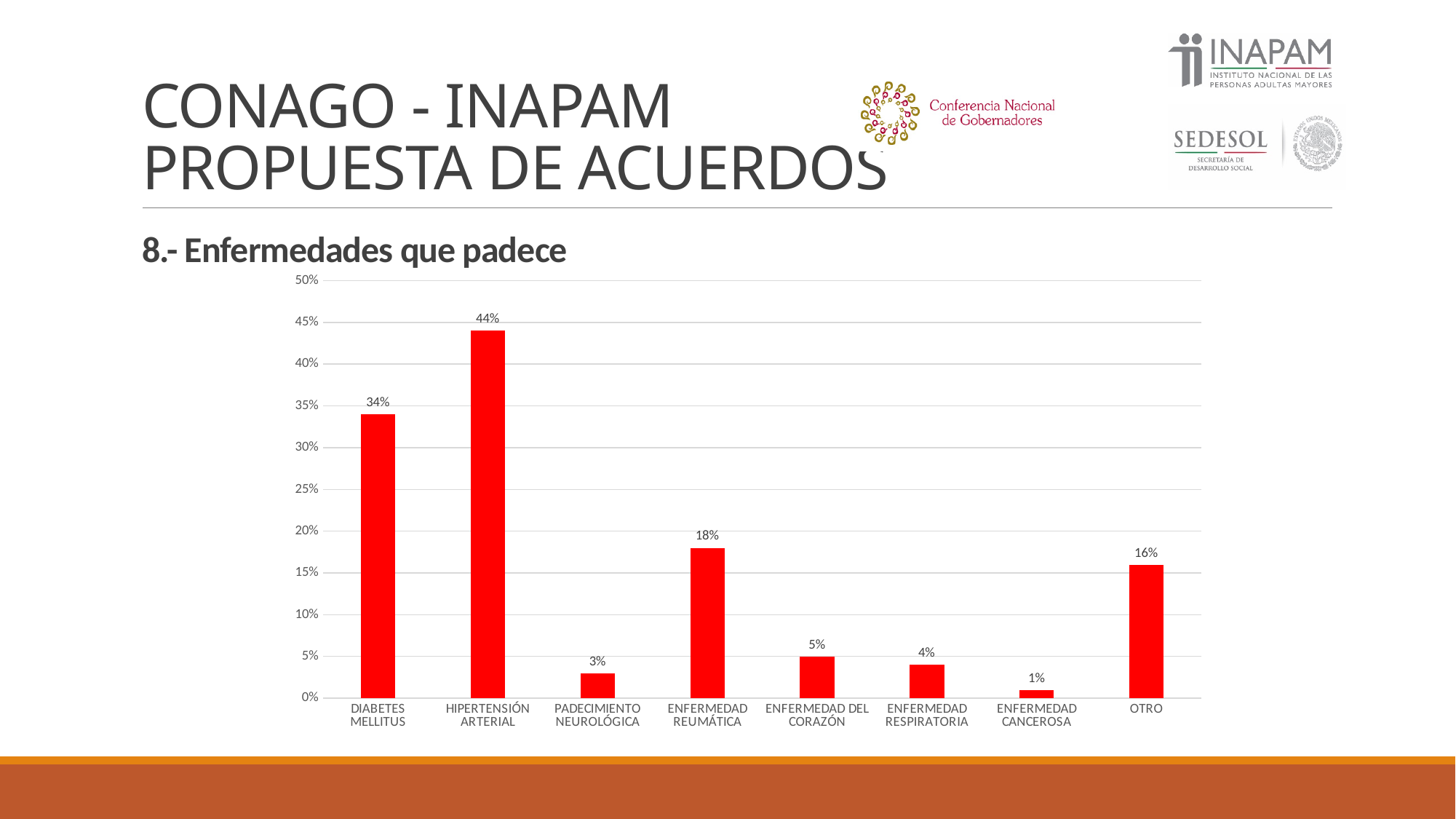
Is the value for ENFERMEDAD REUMÁTICA greater or less than 20%? less Which is larger, the value for ENFERMEDAD DEL CORAZÓN or ENFERMEDAD RESPIRATORIA? ENFERMEDAD DEL CORAZÓN What is the value for OTRO? 16% What is the value for DIABETES MELLITUS? 34% What is the value for HIPERTENSIÓN ARTERIAL? 44% What is the difference between the values for HIPERTENSIÓN ARTERIAL and DIABETES MELLITUS? 10% What is the value for ENFERMEDAD REUMÁTICA? 18% Which category has the lowest value? ENFERMEDAD CANCEROSA How many categories are shown on the chart? 8 What kind of chart is shown on the slide? bar chart Which category has the highest value? HIPERTENSIÓN ARTERIAL What is the value for ENFERMEDAD CANCEROSA? 1%